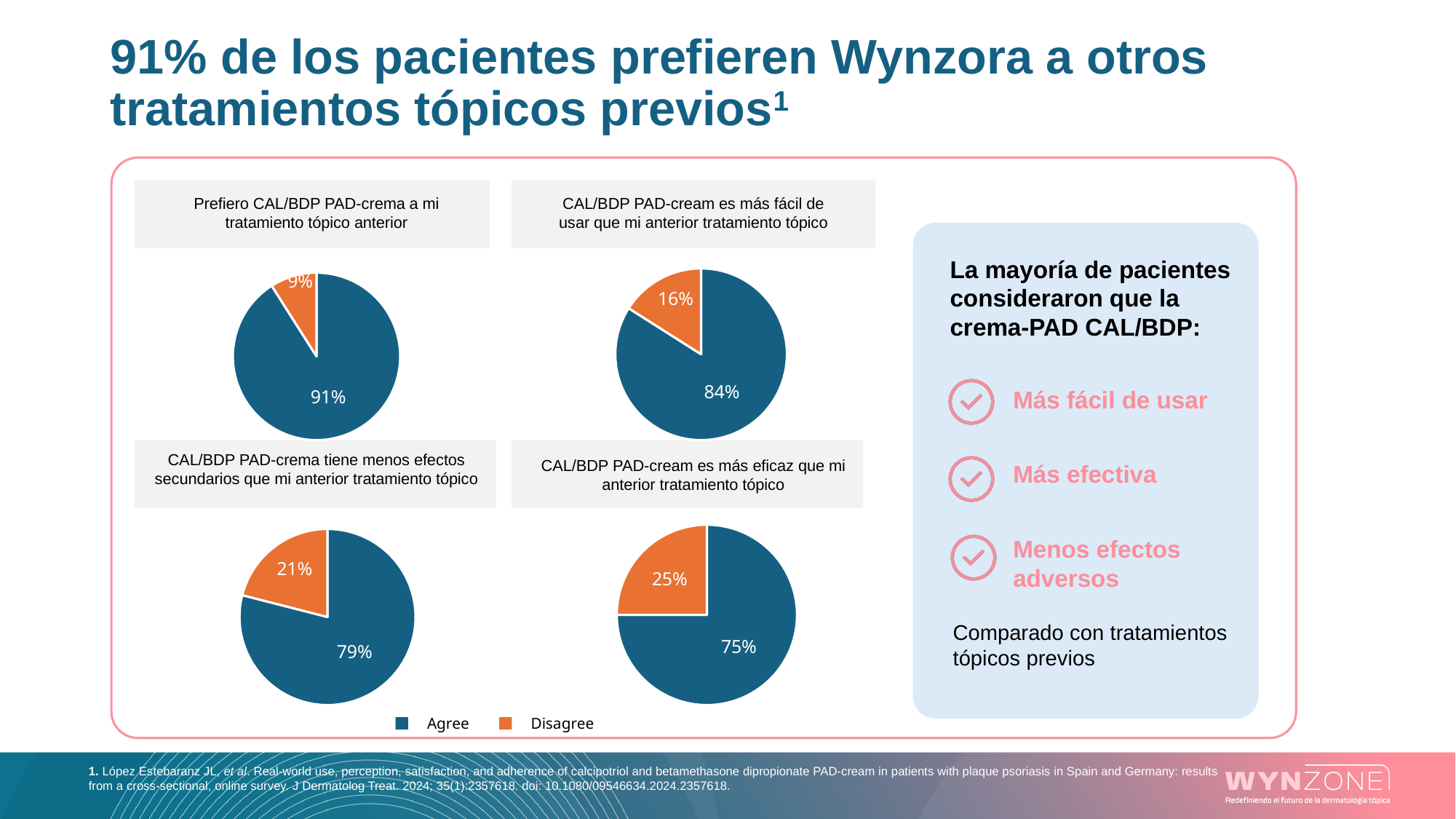
In the top-right pie chart ("CAL/BDP PAD-cream es más fácil de usar que mi anterior tratamiento tópico"), what share of patients agree? 84% Which colour represents "Disagree" in the legend? Orange In the bottom-right pie chart ("CAL/BDP PAD-cream es más eficaz que mi anterior tratamiento tópico"), what share of patients disagree? 25% In the top-left pie chart ("Prefiero CAL/BDP PAD-crema a mi tratamiento tópico anterior"), what share of patients agree? 91% Which of the four pie charts has the largest Disagree share? CAL/BDP PAD-cream es más eficaz que mi anterior tratamiento tópico (25%) How many pie charts are on the slide? 4 How many series does the legend list? 2 What kind of charts are shown on the slide? Pie charts In the bottom-left pie chart ("CAL/BDP PAD-crema tiene menos efectos secundarios"), what is the difference between the Agree and Disagree shares? 58%